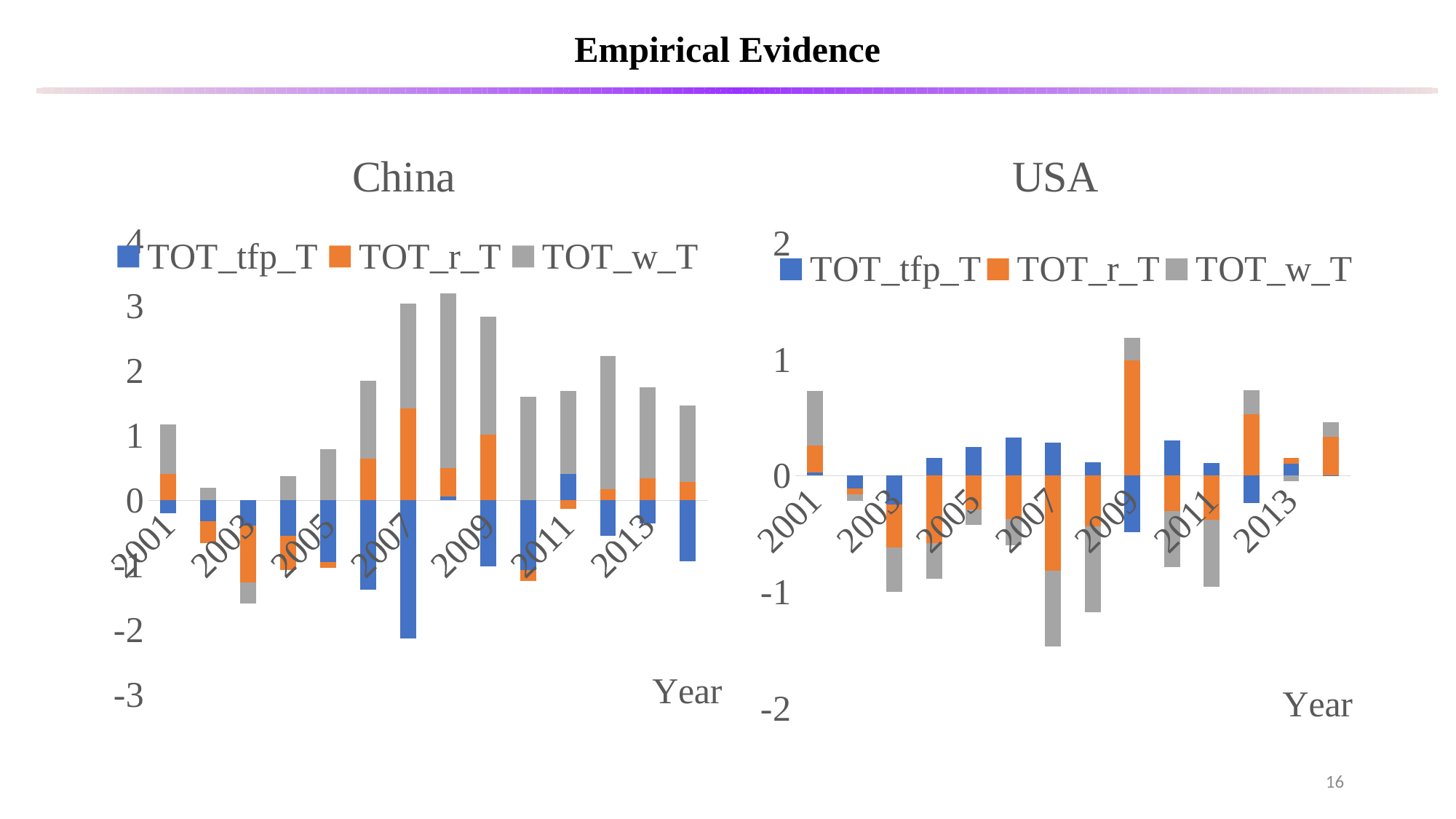
What are the three series named in the legend of the China chart? TOT_tfp_T, TOT_r_T, TOT_w_T In the USA chart, which colour represents TOT_r_T? orange In the China chart, is the top of the stacked bar for 2008 greater or less than 3? greater What type of chart is the China chart? bar chart In the USA chart, which year has the tallest positive stacked bar? 2009 How many series does the legend of the USA chart list? 3 How many yearly bars are plotted in the China chart? 14 In the China chart, is the TOT_tfp_T value for 2007 greater or less than -1? less In the China chart, which year has the lowest (most negative) bar? 2007 What is the highest tick value shown on the y-axis of the China chart? 4 In the USA chart, is the bottom of the stacked bar for 2007 greater or less than -1? less In the USA chart, which year has the lowest (most negative) bar? 2007